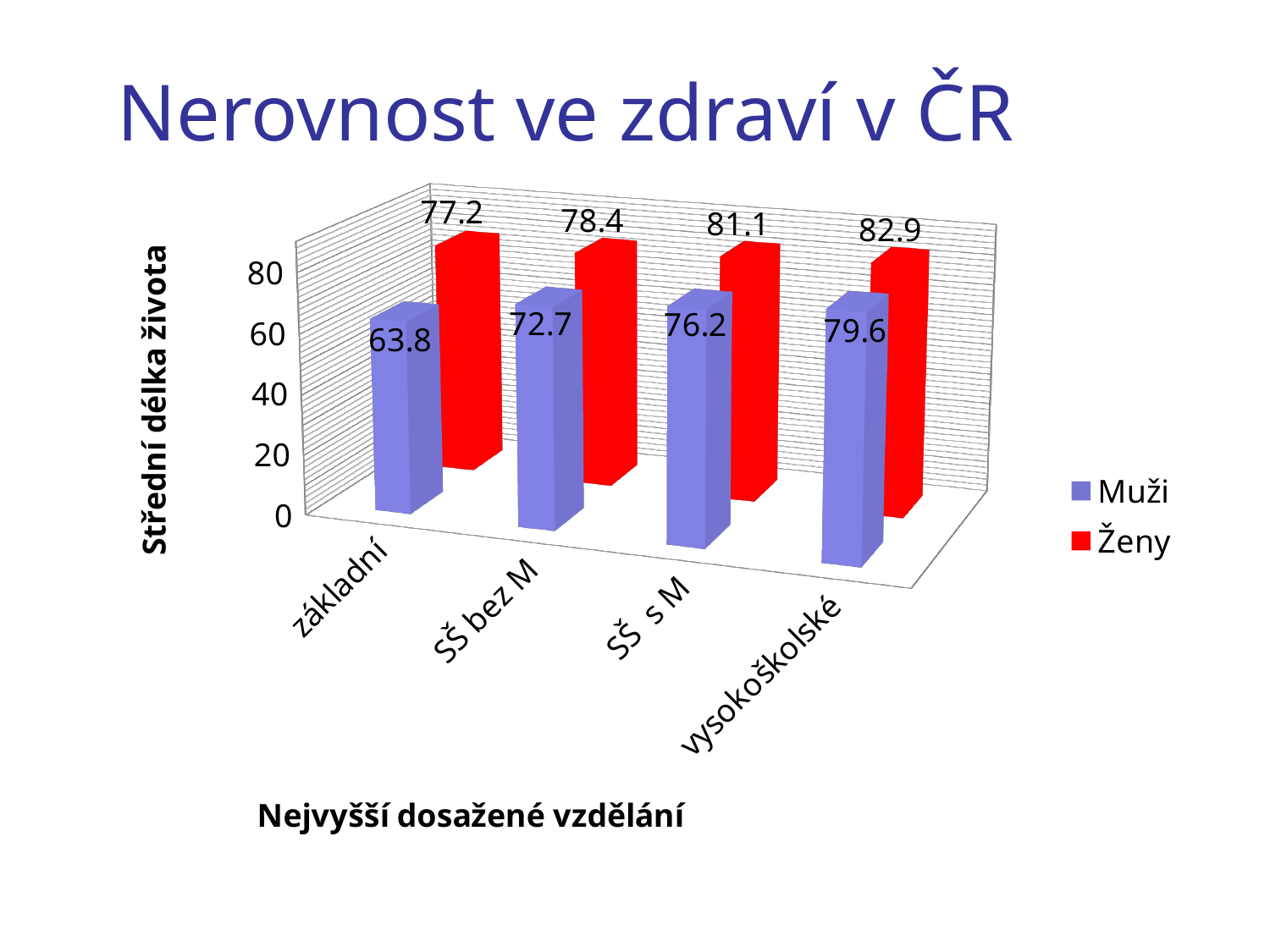
What is the value for Ženy in the SŠ bez M category? 78.4 Which category has the highest value for Muži? vysokoškolské Do the Muži values rise or fall from základní to vysokoškolské? rise What is the difference between Ženy and Muži in the základní category? 13.4 What is the value for Muži in the SŠ s M category? 76.2 What is the value for Ženy in the vysokoškolské category? 82.9 How many education categories are shown on the x axis? 4 What kind of chart is shown on the slide? bar chart What is the value for Muži in the základní category? 63.8 How many series does the legend list? 2 Which category has the lowest value for Ženy? základní Which is larger: Muži in vysokoškolské or Ženy in SŠ bez M? Muži in vysokoškolské